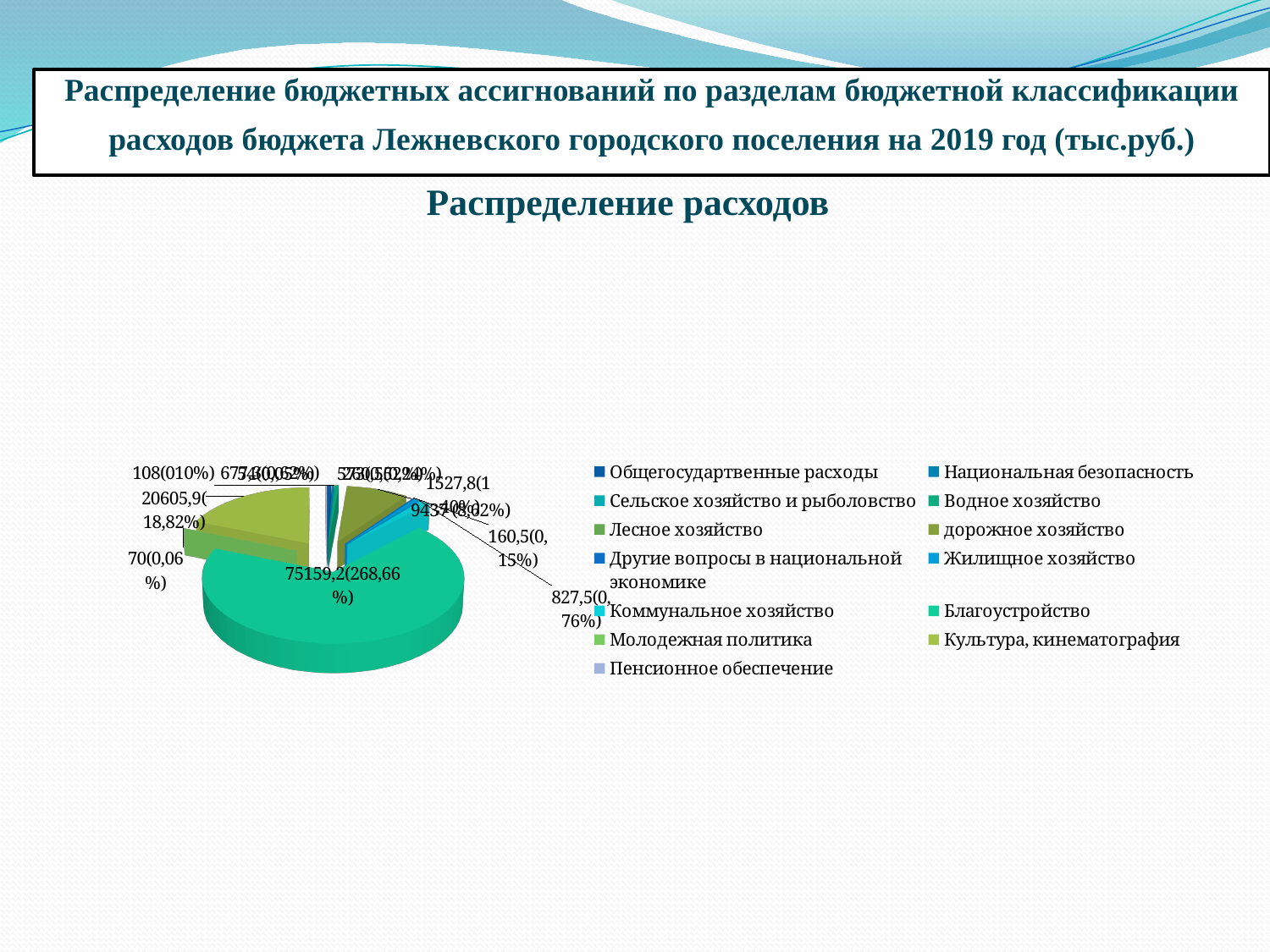
What kind of chart is shown on the slide? pie chart How many entries does the chart legend list? 13 Which printed value is larger: 9437 or 827,5? 9437 What is the first entry in the chart legend? Общегосудартвенные расходы What data label is printed on the second-largest slice of the pie? 20605,9(18,82%) What data label is printed on the largest slice of the pie? 75159,2(268,66%) Does the largest slice take up more or less than half of the pie? more What is the title of the chart? Распределение расходов What is the difference between the value on the largest slice (75159,2) and the value on the second-largest slice (20605,9)? 54553,3